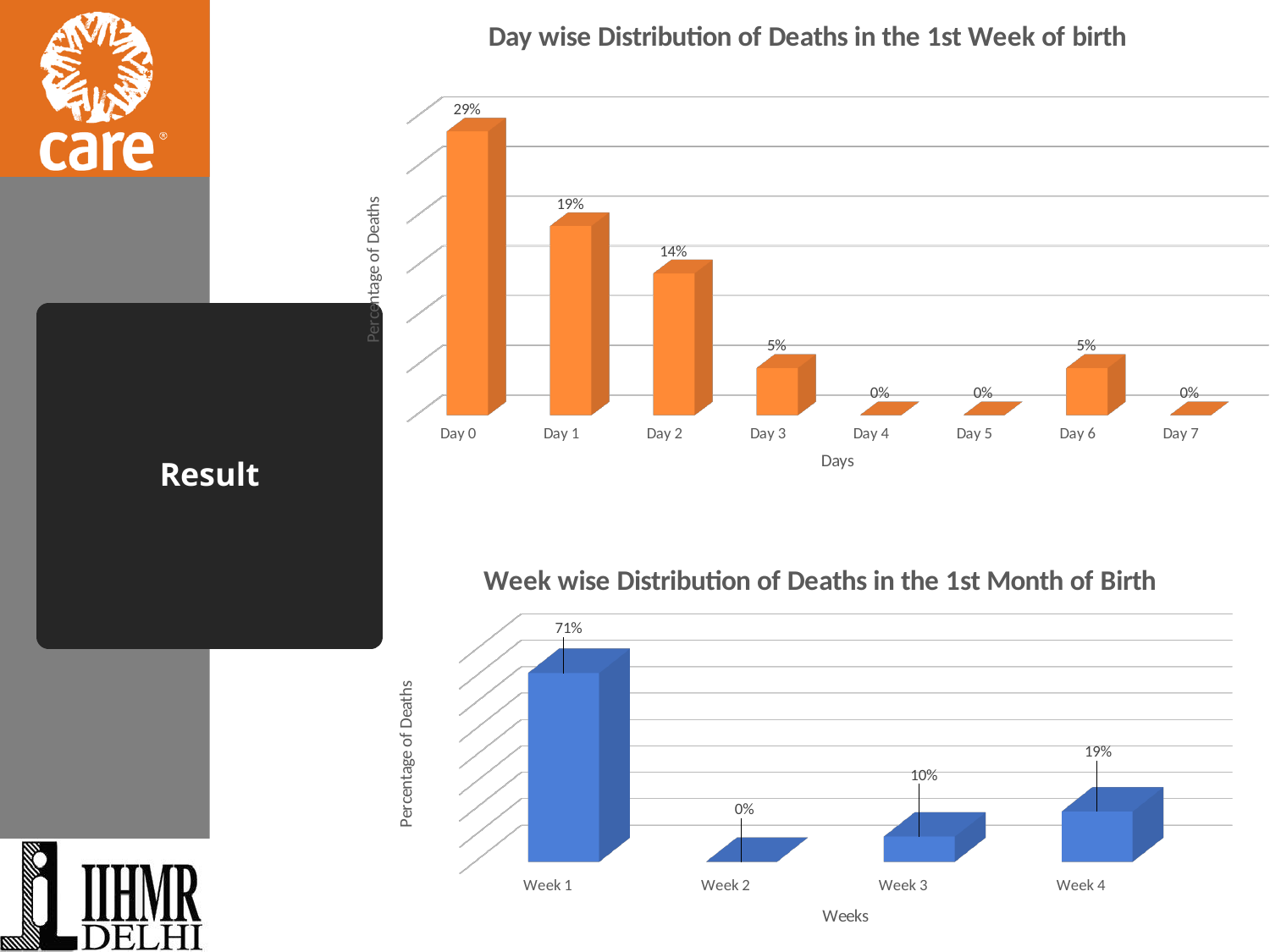
In the 'Week wise Distribution of Deaths in the 1st Month of Birth' chart, which week has the lowest percentage of deaths? Week 2 In the 'Day wise Distribution of Deaths in the 1st Week of birth' chart, what is the label of the x axis? Days In the 'Week wise Distribution of Deaths in the 1st Month of Birth' chart, what is the difference between the values for Week 4 and Week 3? 9% In the 'Day wise Distribution of Deaths in the 1st Week of birth' chart, what is the value for Day 2? 14% What type of chart is the 'Week wise Distribution of Deaths in the 1st Month of Birth' chart? Bar chart In the 'Day wise Distribution of Deaths in the 1st Week of birth' chart, what is the difference between the values for Day 0 and Day 1? 10% In the 'Day wise Distribution of Deaths in the 1st Week of birth' chart, what is the value for Day 0? 29% In the 'Day wise Distribution of Deaths in the 1st Week of birth' chart, which is larger, the value for Day 3 or the value for Day 2? Day 2 In the 'Week wise Distribution of Deaths in the 1st Month of Birth' chart, what is the value for Week 3? 10% In the 'Week wise Distribution of Deaths in the 1st Month of Birth' chart, what is the value for Week 1? 71% In the 'Day wise Distribution of Deaths in the 1st Week of birth' chart, which day has the highest percentage of deaths? Day 0 In the 'Day wise Distribution of Deaths in the 1st Week of birth' chart, how many days are shown on the x axis? 8